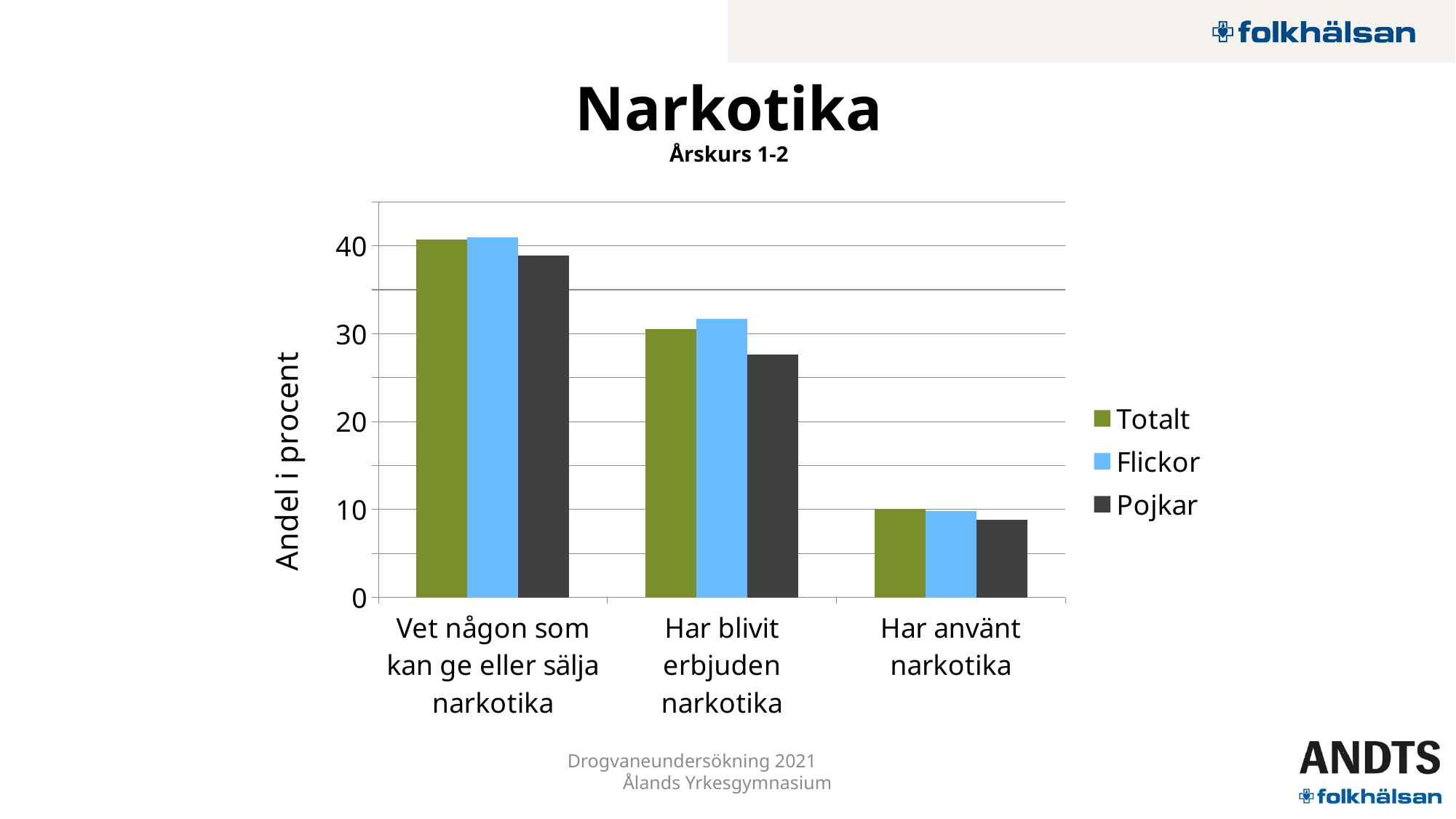
Is the Flickor value for 'Har blivit erbjuden narkotika' greater or less than 30? greater How many series does the legend list? 3 What kind of chart is shown on the slide? bar chart Which category has the highest values? Vet någon som kan ge eller sälja narkotika What is the subtitle shown under the chart title 'Narkotika'? Årskurs 1-2 Do the values rise or fall from left to right along the x axis? fall For 'Har blivit erbjuden narkotika', which is larger: Flickor or Pojkar? Flickor Is the Pojkar value for 'Har blivit erbjuden narkotika' greater or less than 30? less What is the title of the y axis? Andel i procent How many categories are shown on the x axis? 3 Which category has the lowest values? Har använt narkotika Is the Pojkar value for 'Har använt narkotika' greater or less than 10? less